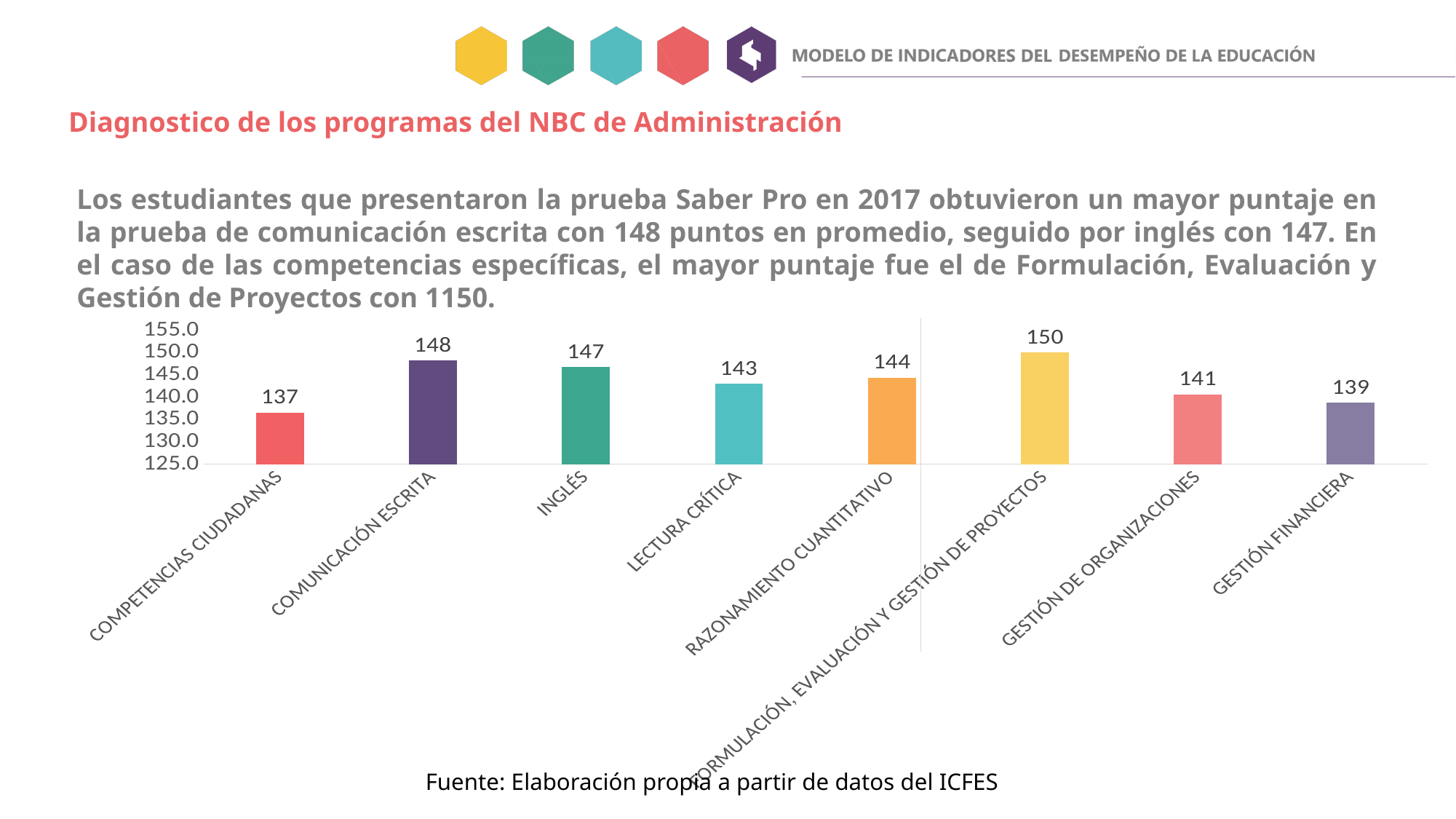
How many categories are shown in the chart? 8 What is the difference between the values for COMUNICACIÓN ESCRITA and COMPETENCIAS CIUDADANAS? 11 Is the value for GESTIÓN DE ORGANIZACIONES greater or less than 145.0? less Which category has the lowest value? COMPETENCIAS CIUDADANAS What is the lowest value shown on the vertical axis? 125.0 What is the value for LECTURA CRÍTICA? 143 What is the value for COMUNICACIÓN ESCRITA? 148 Which is larger, the value for INGLÉS or the value for RAZONAMIENTO CUANTITATIVO? INGLÉS What is the difference between the values for FORMULACIÓN, EVALUACIÓN Y GESTIÓN DE PROYECTOS and GESTIÓN FINANCIERA? 11 Which category has the highest value? FORMULACIÓN, EVALUACIÓN Y GESTIÓN DE PROYECTOS What is the value for GESTIÓN FINANCIERA? 139 What kind of chart is shown on the slide? bar chart